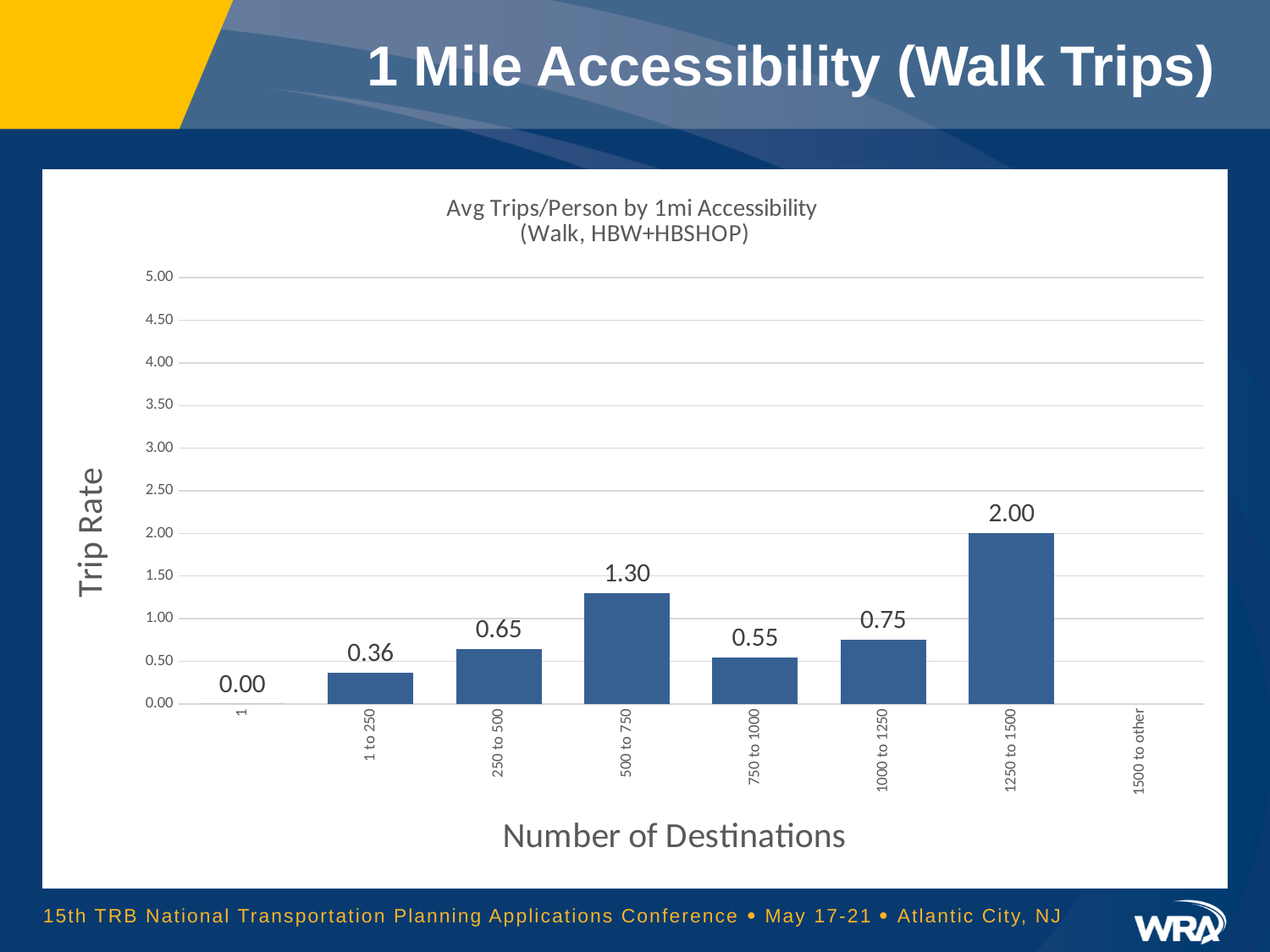
What kind of chart is shown on the slide? bar chart What is the difference between the trip rate for 1000 to 1250 and the trip rate for 750 to 1000? 0.20 How many categories are listed on the x axis? 8 Which has a higher trip rate, 500 to 750 or 1000 to 1250? 500 to 750 What is the difference between the trip rate for 1250 to 1500 and the trip rate for 500 to 750? 0.70 Is the trip rate for 250 to 500 greater or less than 0.50? greater What is the trip rate for the 1250 to 1500 destinations category? 2.00 What is the trip rate for the 750 to 1000 destinations category? 0.55 Which number-of-destinations category has the highest trip rate? 1250 to 1500 What is the trip rate for the 500 to 750 destinations category? 1.30 What is the label of the y axis? Trip Rate What is the trip rate for the 1 to 250 destinations category? 0.36